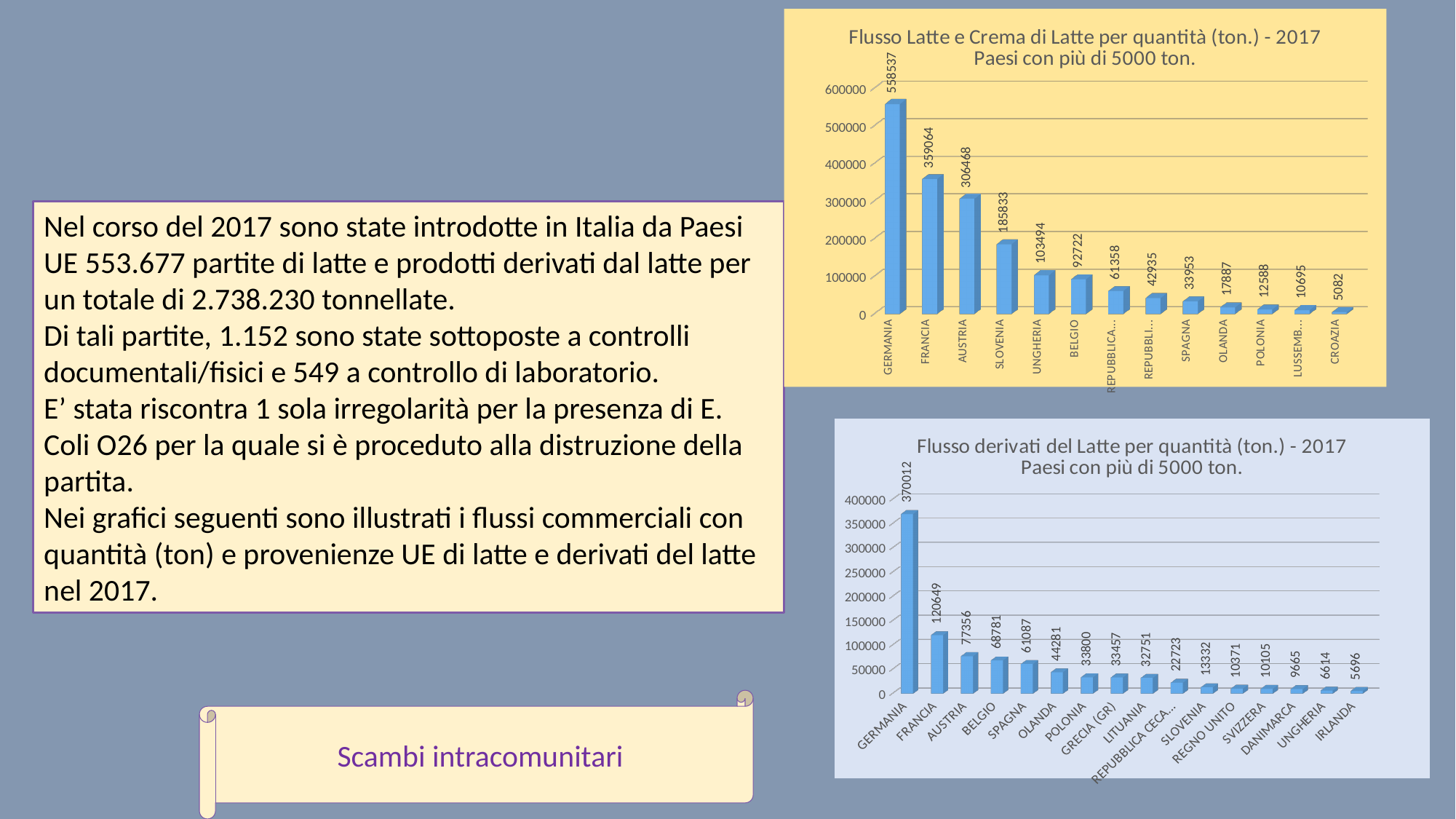
In the top chart (Flusso Latte e Crema di Latte), what is the value for GERMANIA? 558537 In the top chart (Flusso Latte e Crema di Latte), which country has the lowest value? CROAZIA In the bottom chart (Flusso derivati del Latte), what is the value for LITUANIA? 32751 In the bottom chart (Flusso derivati del Latte), how many countries are shown? 16 In the bottom chart (Flusso derivati del Latte), what is the difference between FRANCIA and AUSTRIA? 43293 In the top chart (Flusso Latte e Crema di Latte), what is the difference between FRANCIA and AUSTRIA? 52596 In the top chart (Flusso Latte e Crema di Latte), how many countries are shown? 13 In the bottom chart (Flusso derivati del Latte), which country has the highest value? GERMANIA What type of chart is the bottom chart (Flusso derivati del Latte)? Bar chart In the top chart (Flusso Latte e Crema di Latte), what is the value for SLOVENIA? 185833 In the top chart (Flusso Latte e Crema di Latte), which is larger, BELGIO or UNGHERIA? UNGHERIA In the bottom chart (Flusso derivati del Latte), what is the value for GERMANIA? 370012